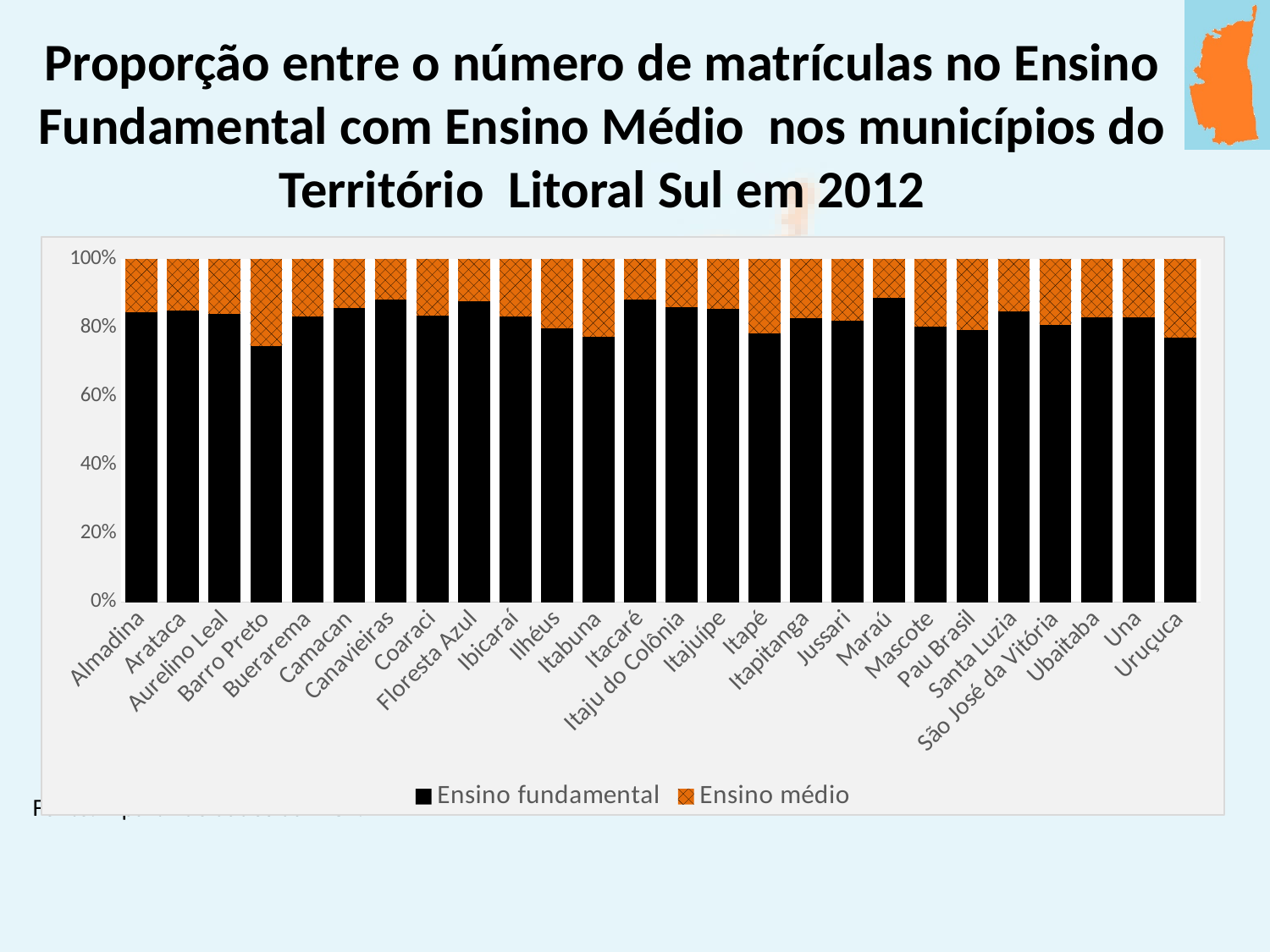
What are the two series named in the legend? Ensino fundamental and Ensino médio How many series does the legend list? 2 Which municipality has the largest share of Ensino médio? Barro Preto Which municipality has the lowest share of Ensino fundamental? Barro Preto Is the Ensino fundamental share for Maraú greater or less than 80%? greater Which has the larger Ensino médio share, Barro Preto or Canavieiras? Barro Preto How many municipalities are shown on the x axis? 26 Is the Ensino fundamental share for Uruçuca greater or less than 80%? less What kind of chart is shown on the slide? Stacked bar chart Which has the larger Ensino fundamental share, Barro Preto or Maraú? Maraú Is the Ensino fundamental share for Itacaré greater or less than 80%? greater